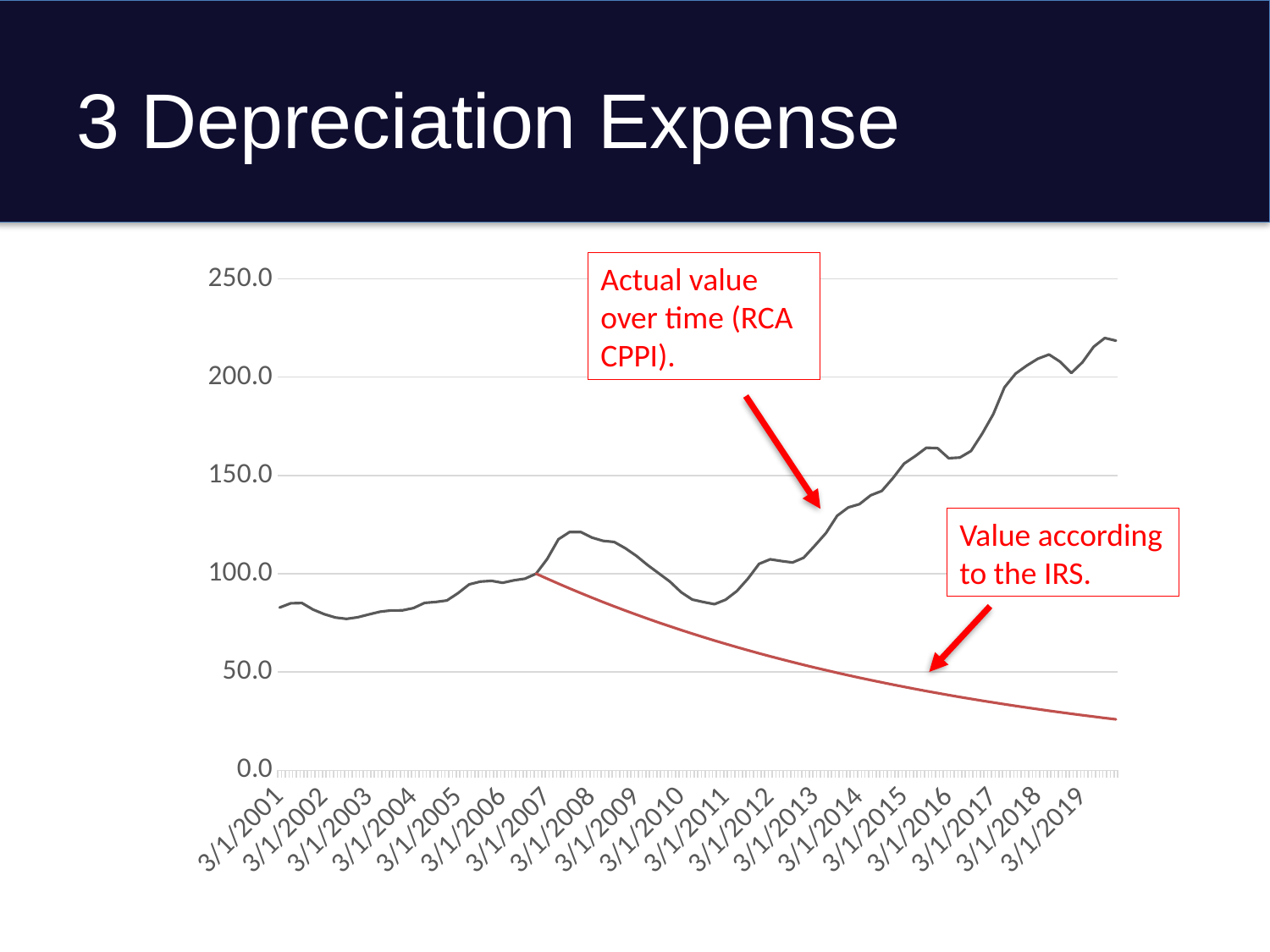
How many lines (series) are plotted on the chart? 2 Is the actual value (RCA CPPI) at 3/1/2019 greater or less than 200? greater What does the annotation say the red line represents? Value according to the IRS. Is the actual value (RCA CPPI) at 3/1/2011 greater or less than 100? less What kind of chart is shown on the slide? line chart What does the annotation say the dark line represents? Actual value over time (RCA CPPI). Does the value according to the IRS rise or fall from 3/1/2007 to 3/1/2019? fall At 3/1/2015, which is larger: the actual value (RCA CPPI) or the value according to the IRS? Actual value (RCA CPPI) Is the value according to the IRS at 3/1/2019 greater or less than 50? less Does the actual value (RCA CPPI) rise or fall from 3/1/2011 to 3/1/2019? rise